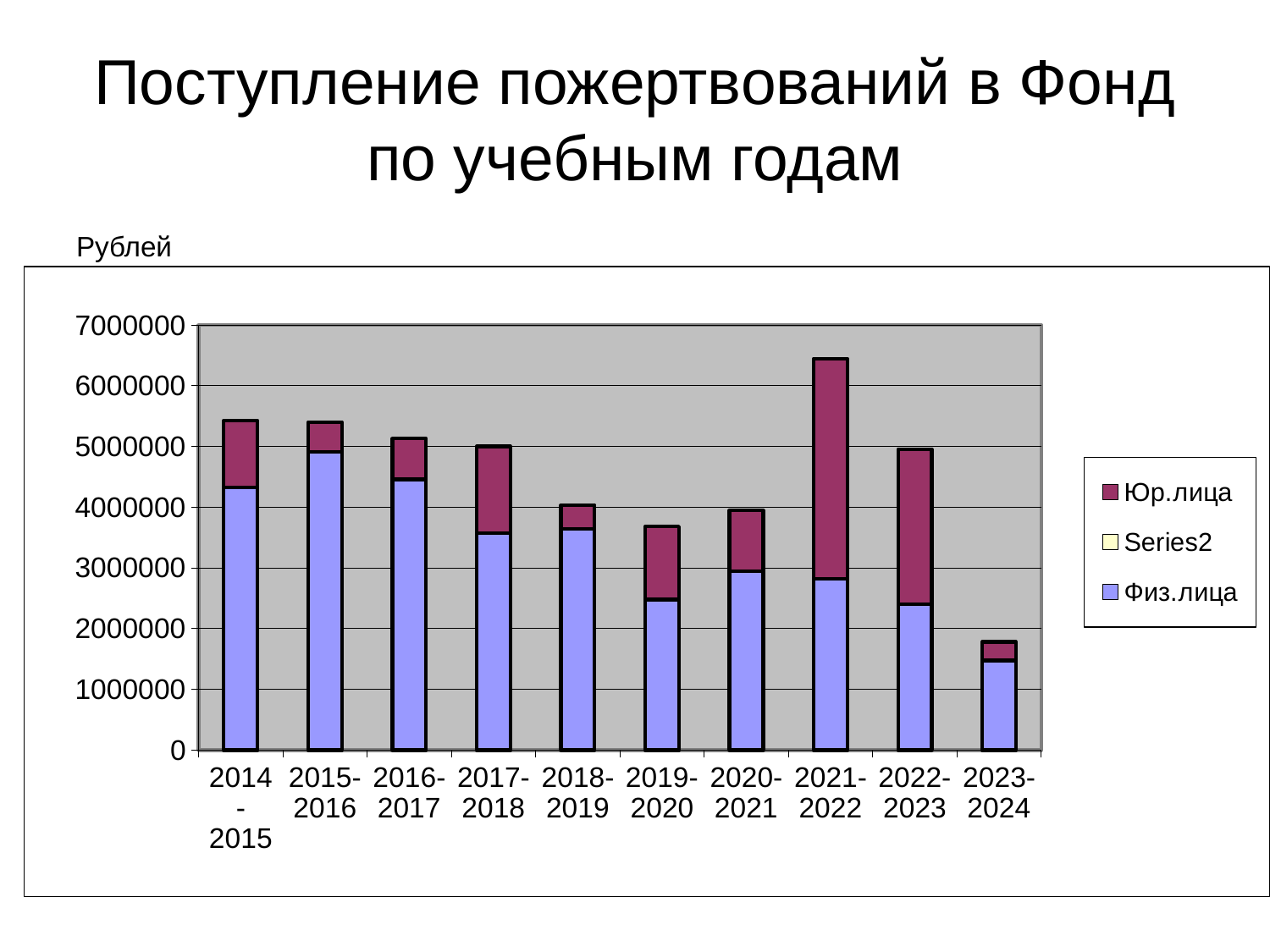
What unit label is shown above the chart's vertical axis? Рублей Is the total bar for 2021-2022 greater or less than 6000000? greater How many series does the legend list? 3 Is the Физ.лица value for 2019-2020 greater or less than 3000000? less Which has the larger total bar, 2021-2022 or 2022-2023? 2021-2022 How many academic years (categories) are shown on the x axis? 10 Which has the larger Физ.лица segment, 2014-2015 or 2019-2020? 2014-2015 Is the total bar for 2023-2024 greater or less than 2000000? less What kind of chart is shown on the slide? Stacked bar chart Which academic year has the largest Физ.лица segment? 2015-2016 Which academic year has the lowest total bar? 2023-2024 Which academic year has the highest total bar? 2021-2022